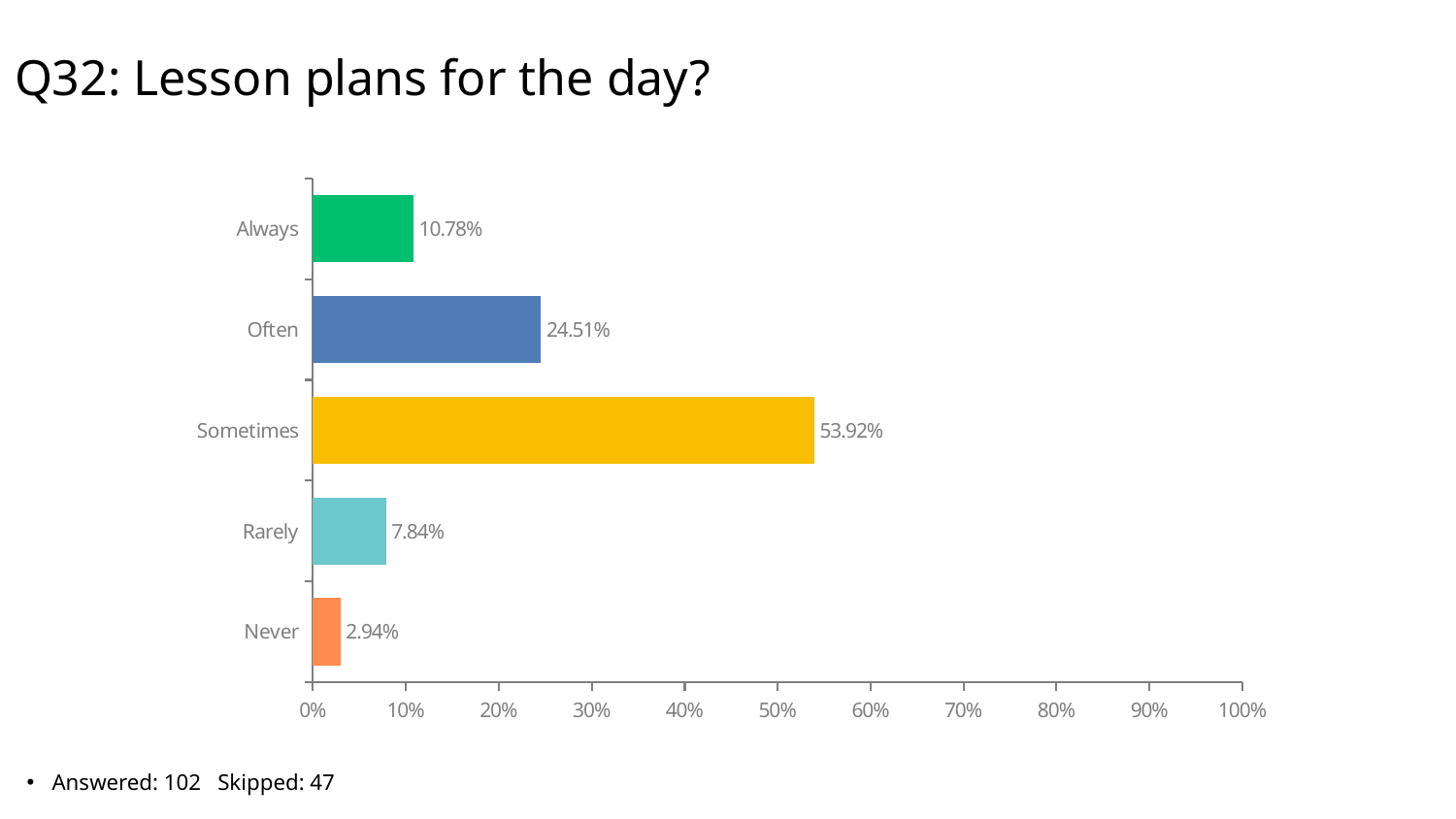
Which is larger, the value for Always or the value for Rarely? Always What kind of chart is shown on the slide? bar chart What is the value for Never? 2.94% How many categories are shown in the chart? 5 What is the value for Often? 24.51% What is the difference between the values for Always and Rarely? 2.94% Which category has the highest value? Sometimes Is the value for Often greater or less than 20%? greater Which category has the lowest value? Never What is the value for Sometimes? 53.92% What is the difference between the values for Sometimes and Often? 29.41% What is the title of the chart? Q32: Lesson plans for the day?